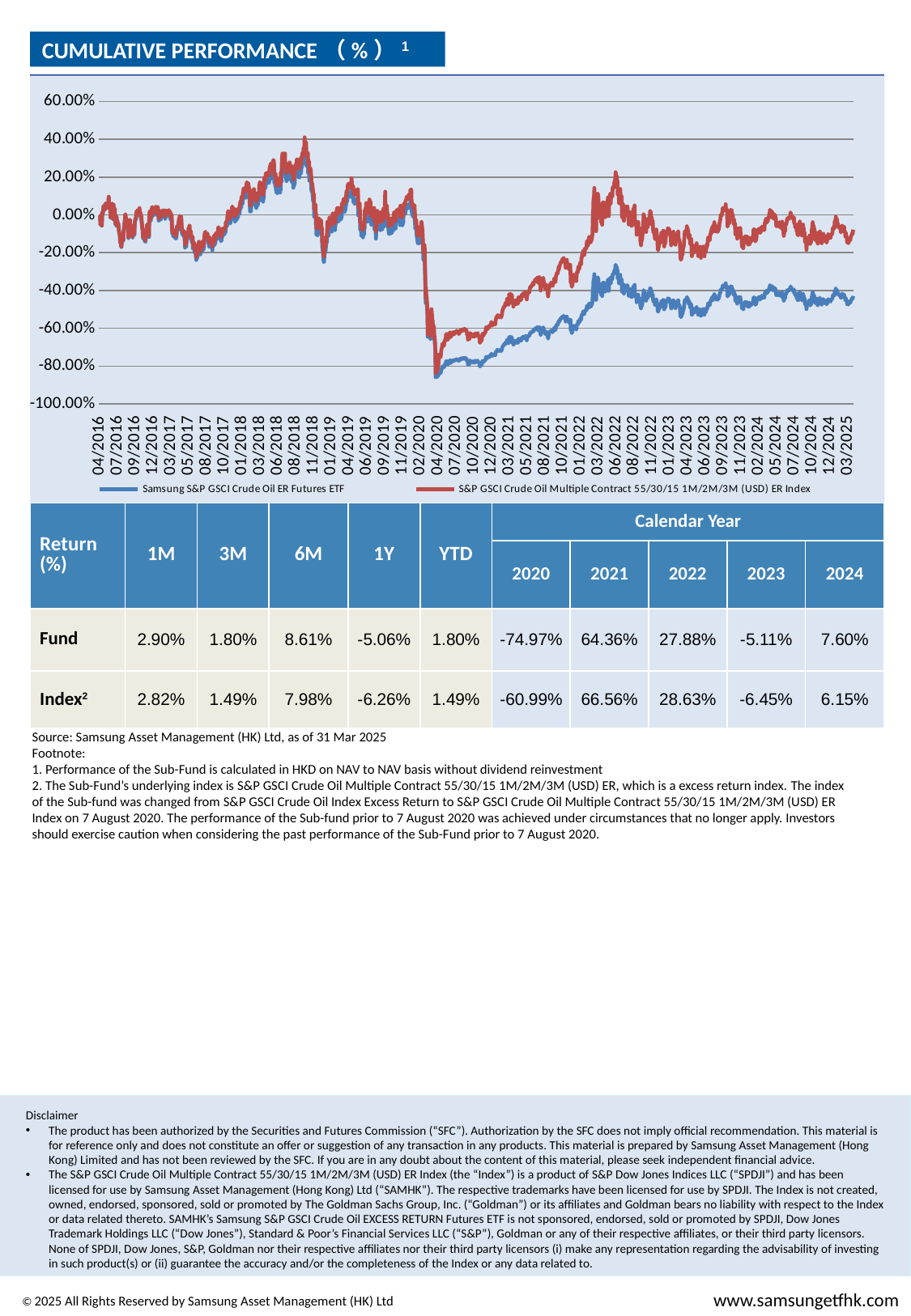
At the right end of the cumulative performance chart (03/2025), which series is higher: the ETF or the Index? The Index Which series in the cumulative performance chart is drawn in red? S&P GSCI Crude Oil Multiple Contract 55/30/15 1M/2M/3M (USD) ER Index In the cumulative performance chart, do both series generally rise or fall between 04/2020 and 06/2022? Rise In the cumulative performance chart, do both series rise or fall between 02/2020 and 04/2020? Fall In the cumulative performance chart, is the value of the Index series at 03/2025 greater or less than -20.00%? greater In the cumulative performance chart, is the value of the ETF series around 04/2020 greater or less than -60.00%? less What kind of chart is shown under the title "CUMULATIVE PERFORMANCE (%)"? Line chart Around 04/2020, which series in the cumulative performance chart is lower: the ETF or the Index? The ETF Which series in the cumulative performance chart is drawn in blue? Samsung S&P GSCI Crude Oil ER Futures ETF In the cumulative performance chart, is the peak of the Index series around 06/2022 greater or less than 0.00%? greater How many series does the legend of the cumulative performance chart list? 2